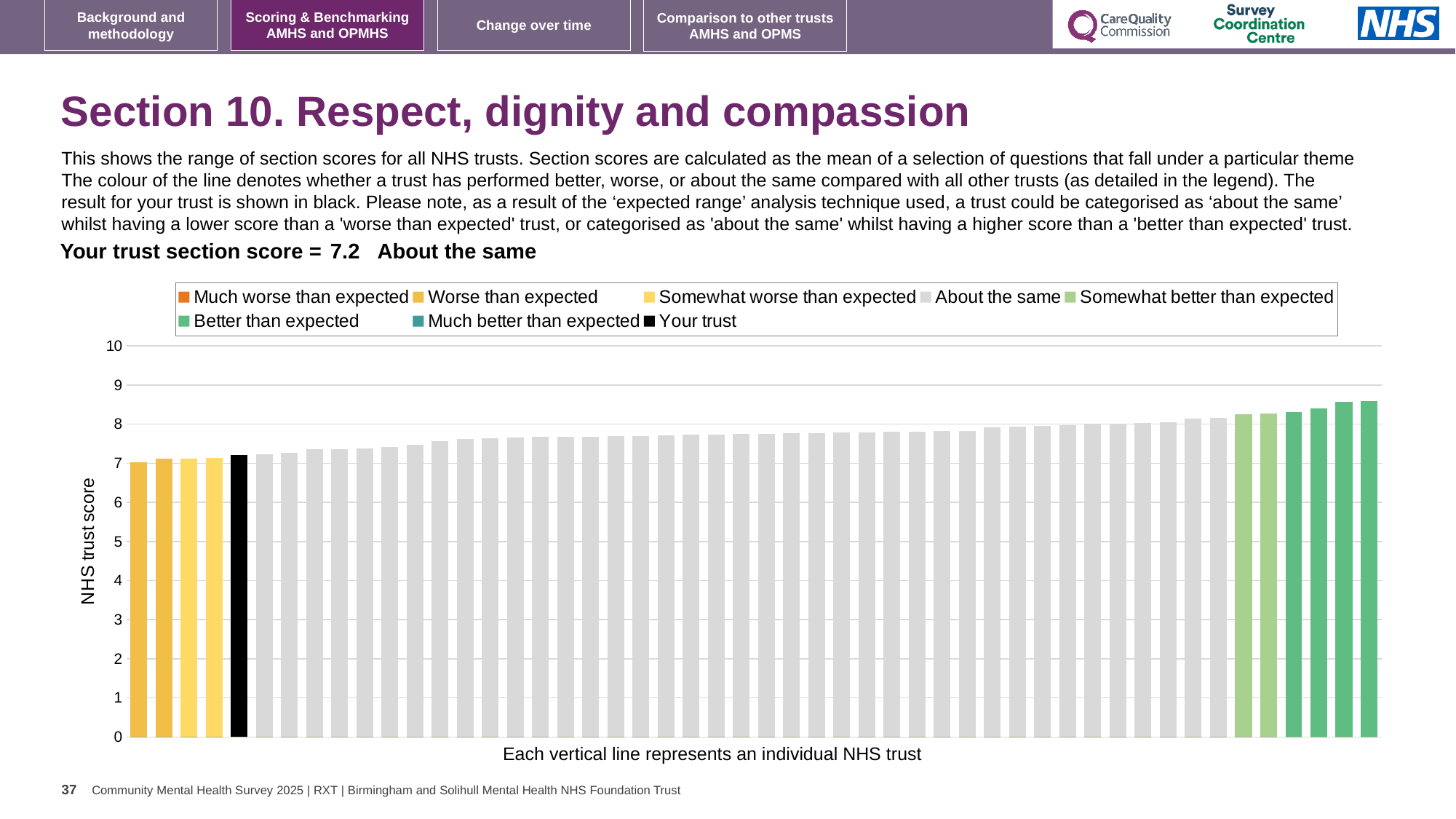
What is the section score for your trust? 7.2 What colour is the bar for your trust? black Is the value for your trust greater or less than 5? greater Do the bar values rise or fall from left to right along the x axis? rise What kind of chart is shown on the slide? bar chart Which category is your trust's section score placed in? About the same Is the value of the lowest bar greater or less than 6? greater What is the label on the vertical axis? NHS trust score Is the value of the highest bar greater or less than 8? greater Which legend category does the highest bar belong to? Better than expected How many entries does the chart legend list? 8